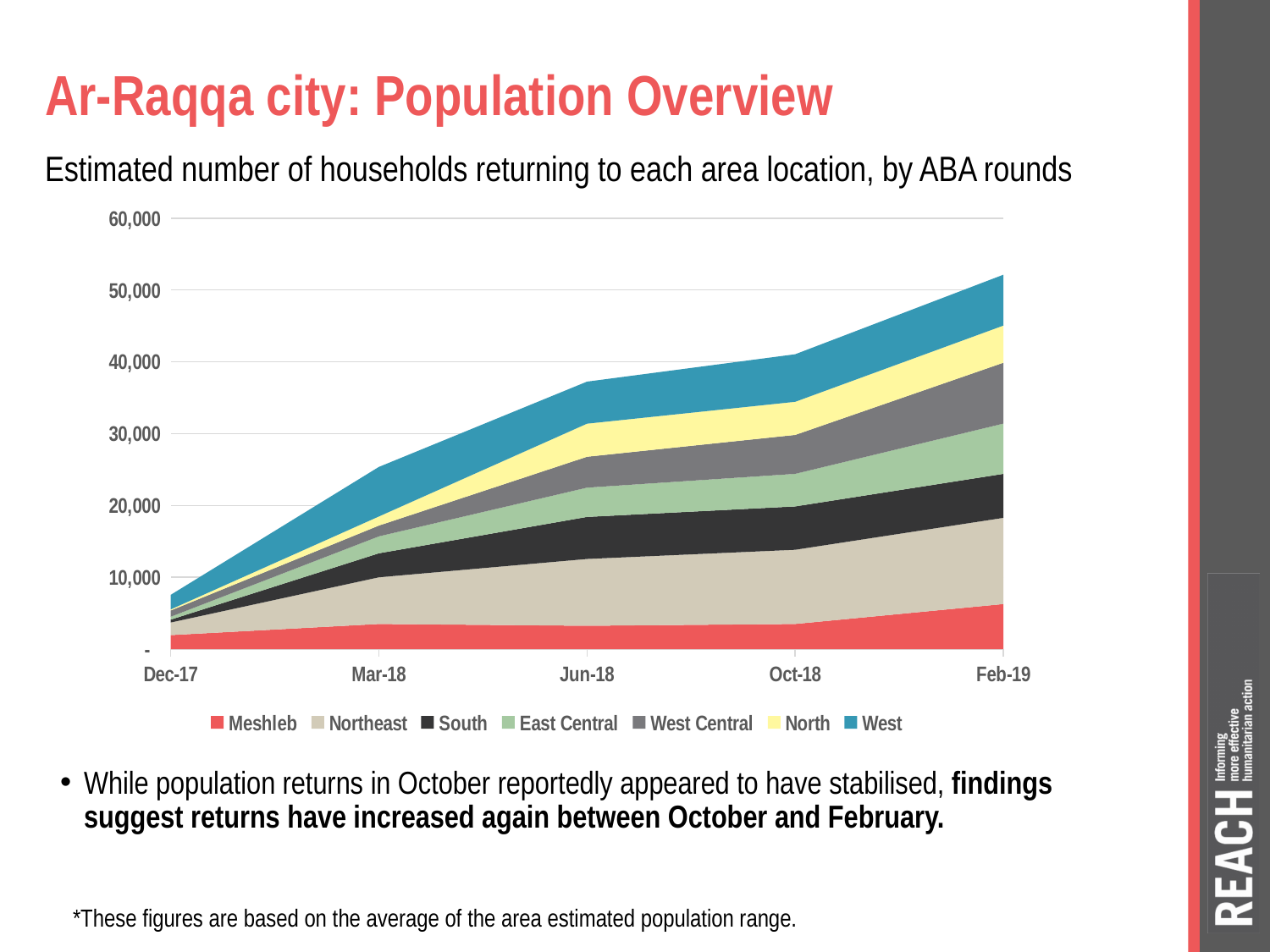
Is the total estimated number of households at Feb-19 greater or less than 50,000? greater How many ABA rounds (points along the x axis) are shown in the chart? 5 Which ABA round has the highest total estimated number of returning households? Feb-19 Does the total estimated number of returning households rise or fall from Dec-17 to Feb-19? Rise How many series does the legend list? 7 Is the total estimated number of households at Dec-17 greater or less than 10,000? less Is the total estimated number of households at Jun-18 greater or less than 40,000? less Which area is shown in red at the bottom of the stacked chart? Meshleb What kind of chart is shown on the slide? Stacked area chart Which ABA round has the lowest total estimated number of returning households? Dec-17